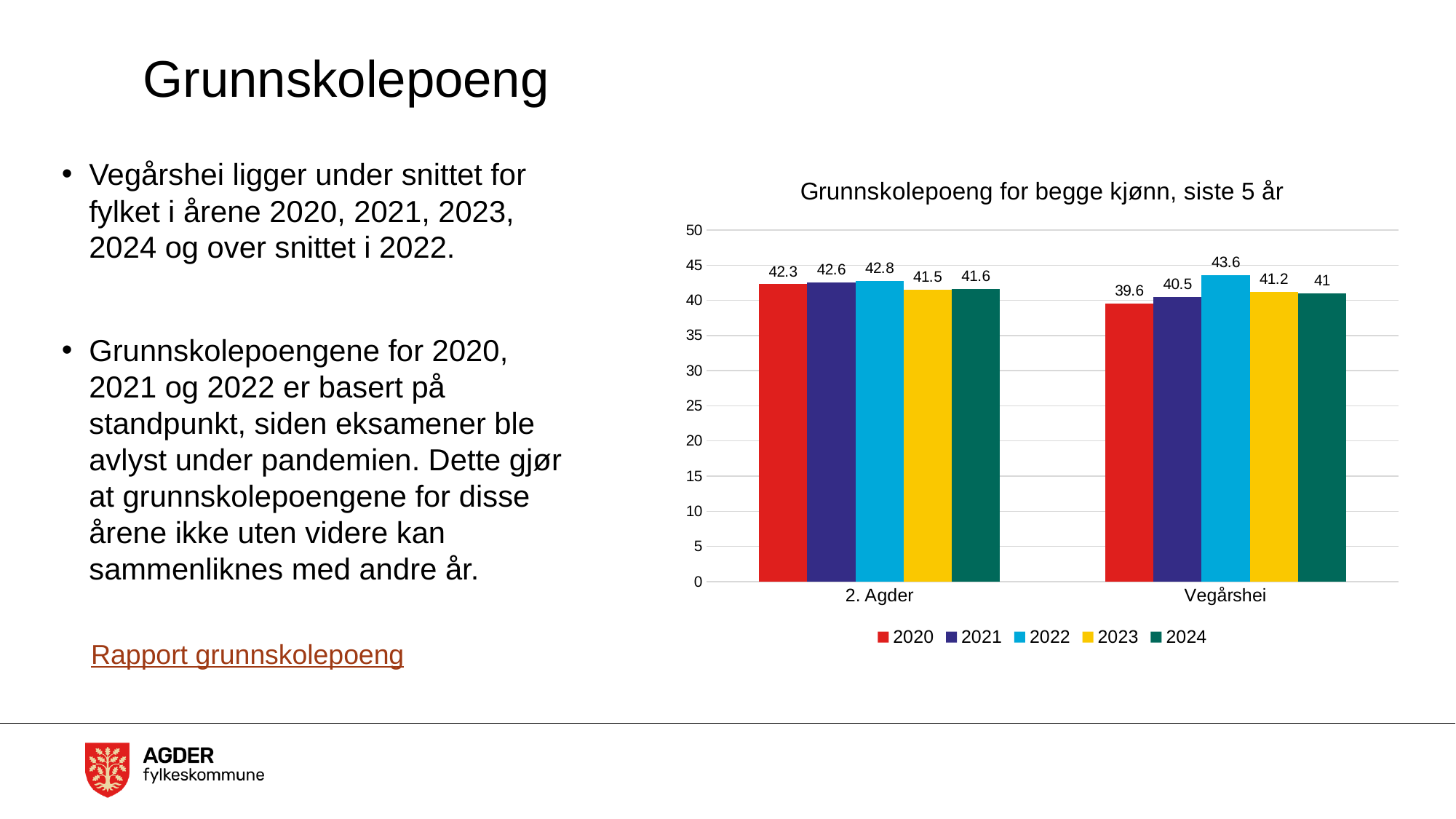
What is the value for 2. Agder in 2022? 42.8 What kind of chart is shown? bar chart What is the difference between the 2022 values for Vegårshei and 2. Agder? 0.8 What is the value for Vegårshei in 2024? 41 What is the value for Vegårshei in 2020? 39.6 Which year has the highest value for Vegårshei? 2022 Which year has the lowest value for 2. Agder? 2023 How many series does the legend list? 5 Which colour represents the 2023 series in the legend? yellow What is the title of the chart? Grunnskolepoeng for begge kjønn, siste 5 år Which is larger, the 2021 value for 2. Agder or the 2021 value for Vegårshei? 2. Agder How many categories are shown on the x axis? 2